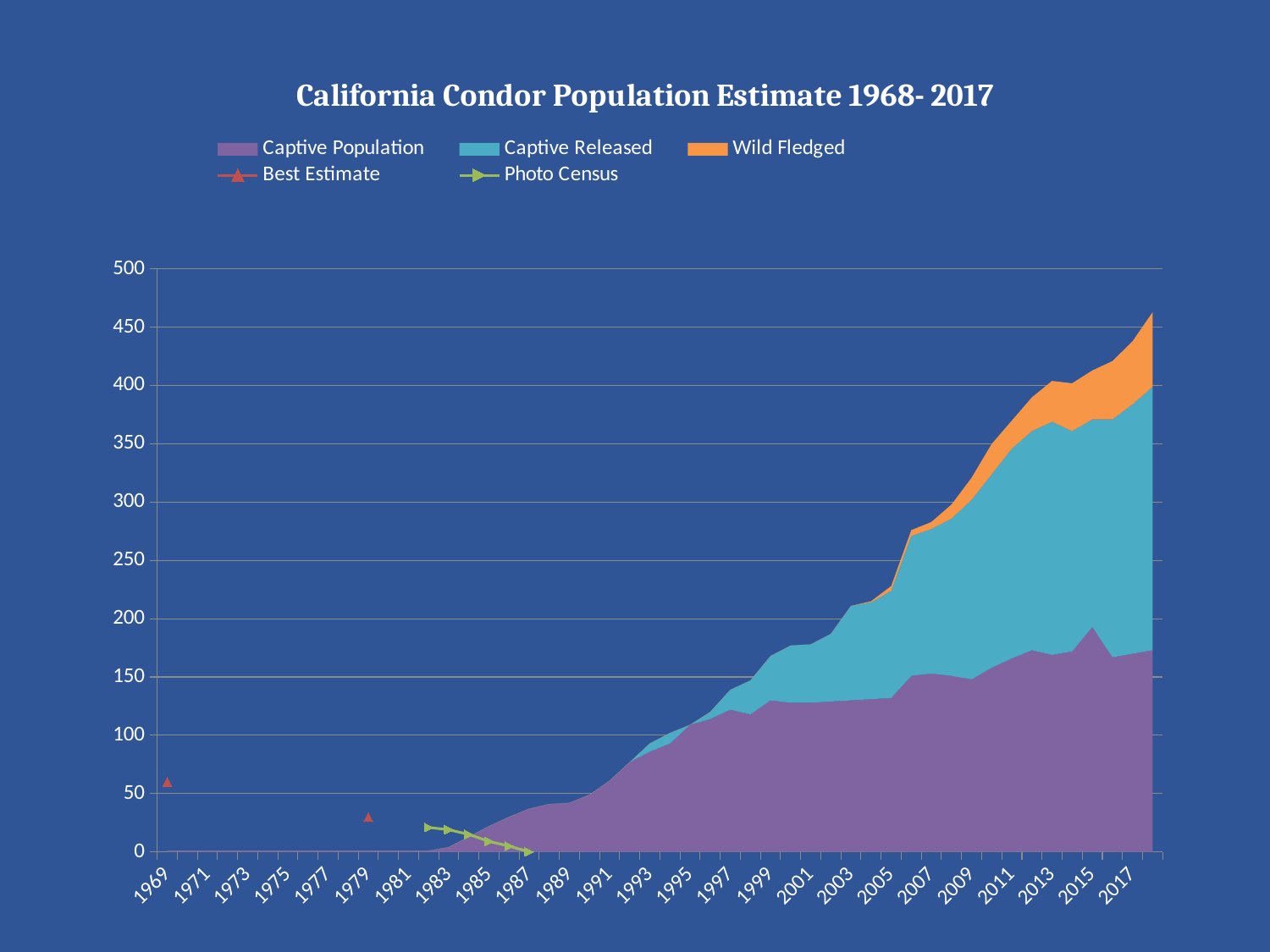
Does the total stacked population rise or fall from 1989 to 2017? Rise Is the Best Estimate value in 1979 greater or less than 50? less Is the Captive Population value in 2017 greater or less than 150? greater What kind of chart is shown on the slide? Stacked area chart with line series Is the Best Estimate value in 1969 greater or less than 50? greater How many series does the legend list? 5 What is the title of the chart? California Condor Population Estimate 1968- 2017 Which colour represents the Wild Fledged series? Orange How many Best Estimate data points are plotted? 2